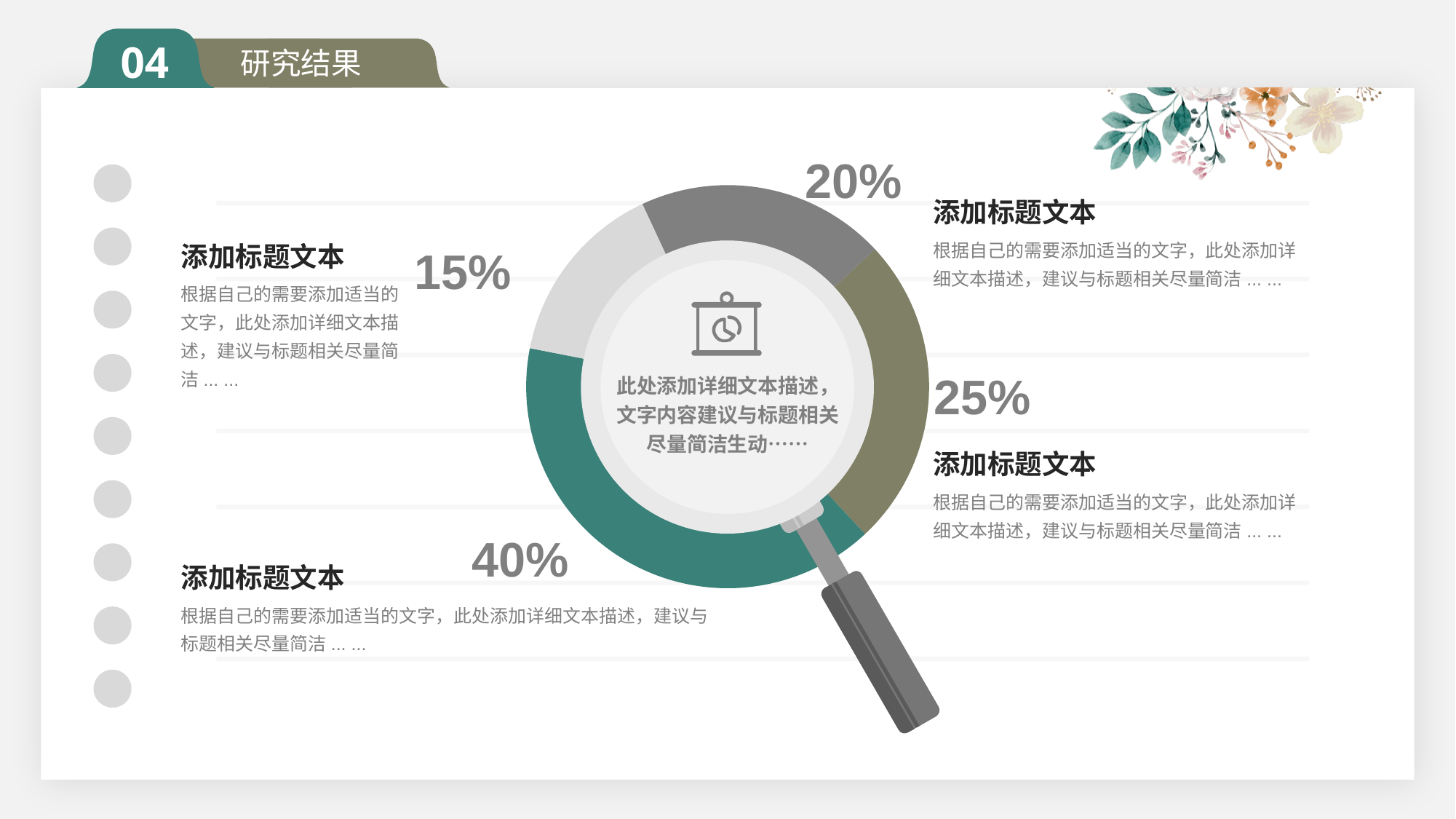
What kind of chart is shown on the slide? Donut chart What is the section title shown in the header of the slide? 研究结果 What percentage is labelled on the light gray segment on the left of the donut chart? 15% How many segments does the donut chart have? 4 What is the largest percentage shown on the donut chart? 40% What percentage is labelled on the teal segment of the donut chart? 40% What is the difference between the largest and smallest percentages on the donut chart? 25% What percentage is labelled on the dark gray segment at the top of the donut chart? 20% Which is larger on the donut chart, the olive-green segment or the dark gray segment? The olive-green segment (25%) What do the four percentages on the donut chart add up to? 100% What percentage is labelled on the olive-green segment on the right of the donut chart? 25% What is the smallest percentage shown on the donut chart? 15%